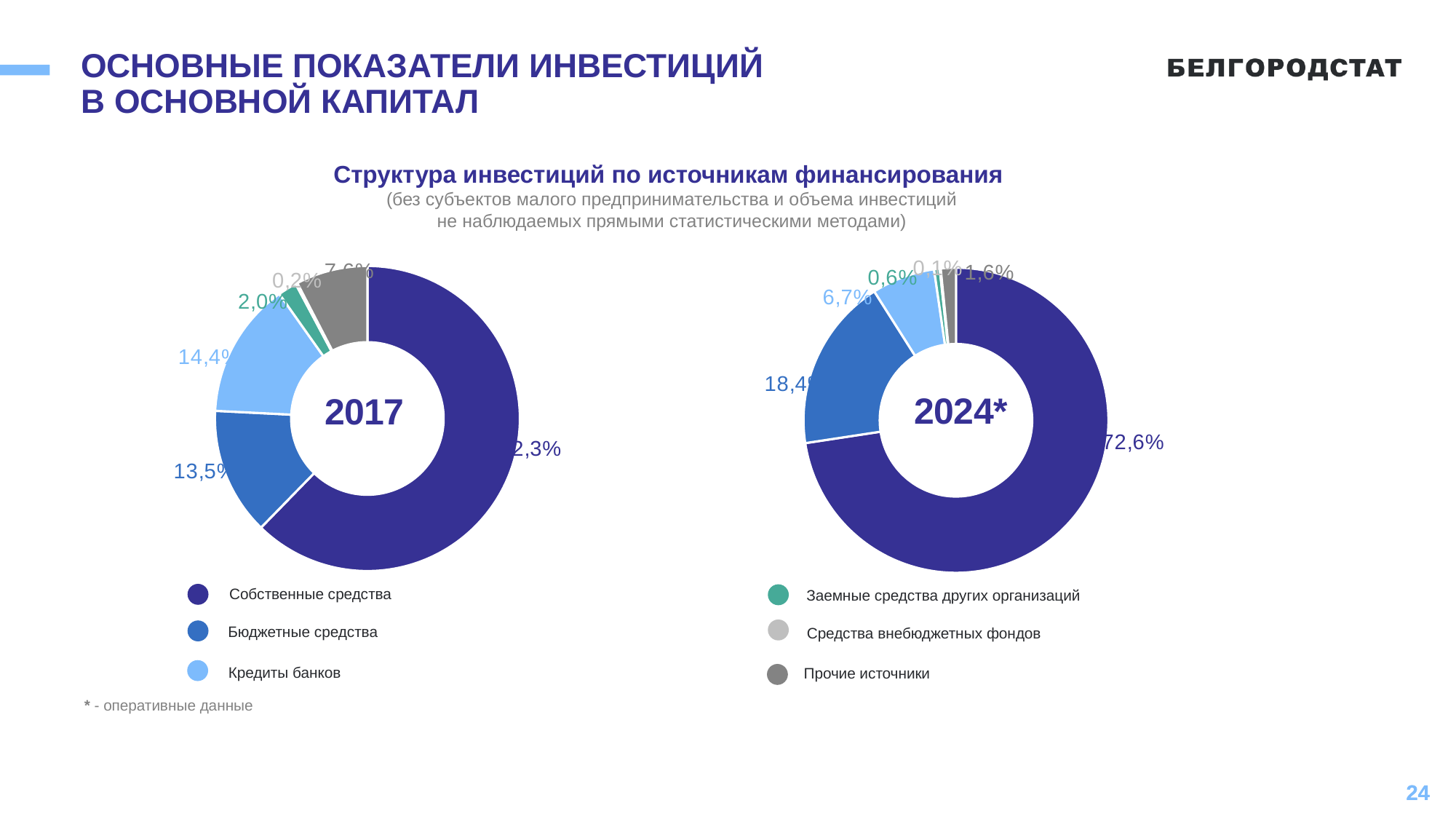
In the 2024* chart, which source has the smallest share? Средства внебюджетных фондов In the 2017 chart, which is larger: the share of Кредиты банков or Бюджетные средства? Кредиты банков In the 2017 chart, what is the share of Бюджетные средства? 13,5% What is the title of the chart section on the slide? Структура инвестиций по источникам финансирования In the 2017 chart, what is the share of Прочие источники? 7,6% In the 2024* chart, which source has the largest share? Собственные средства In the 2024* chart, what is the share of Собственные средства? 72,6% What kind of chart is used for the 2017 data on the slide? Pie (donut) chart In the 2017 chart, what is the share of Кредиты банков? 14,4% In the 2024* chart, what is the share of Кредиты банков? 6,7% How many categories does the legend list for the charts? 6 In the 2024* chart, what is the difference between the shares of Кредиты банков and Прочие источники? 5,1 percentage points